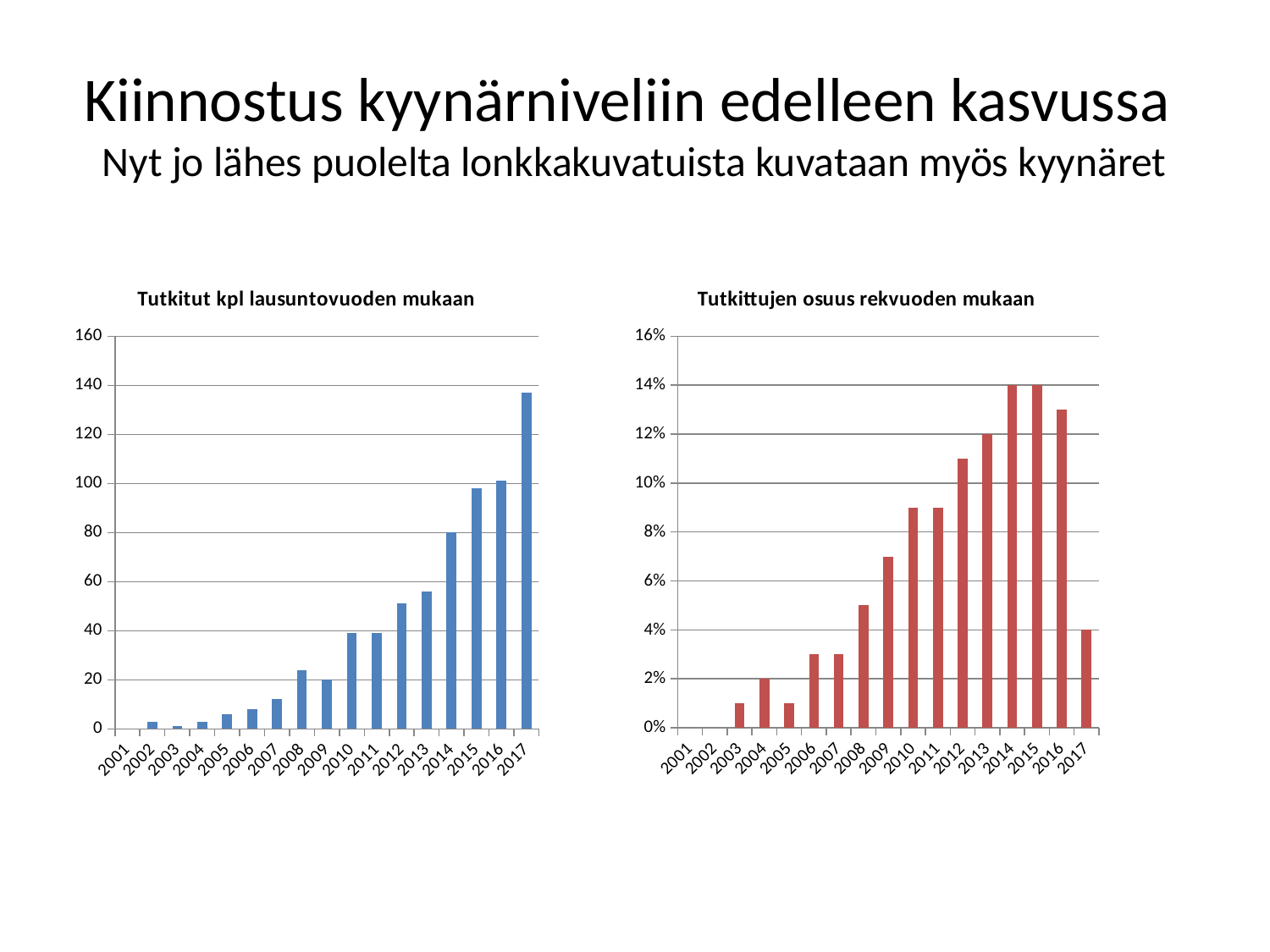
What type of chart is the left chart titled 'Tutkitut kpl lausuntovuoden mukaan'? bar chart How many years are shown on the x axis of the left chart 'Tutkitut kpl lausuntovuoden mukaan'? 17 In the left chart 'Tutkitut kpl lausuntovuoden mukaan', which year has the highest value? 2017 In the left chart 'Tutkitut kpl lausuntovuoden mukaan', is the value for 2017 greater or less than 120? greater In the left chart 'Tutkitut kpl lausuntovuoden mukaan', is the value for 2012 greater or less than 40? greater In the right chart 'Tutkittujen osuus rekvuoden mukaan', what is the value for 2014? 14% In the right chart 'Tutkittujen osuus rekvuoden mukaan', which is larger, the value for 2012 or the value for 2017? 2012 What colour are the bars in the right chart 'Tutkittujen osuus rekvuoden mukaan'? red In the left chart 'Tutkitut kpl lausuntovuoden mukaan', is the value for 2009 greater or less than 40? less In the right chart 'Tutkittujen osuus rekvuoden mukaan', what is the value for 2017? 4% In the right chart 'Tutkittujen osuus rekvuoden mukaan', what is the value for 2013? 12% In the left chart 'Tutkitut kpl lausuntovuoden mukaan', do the values generally rise or fall from 2001 to 2017? rise